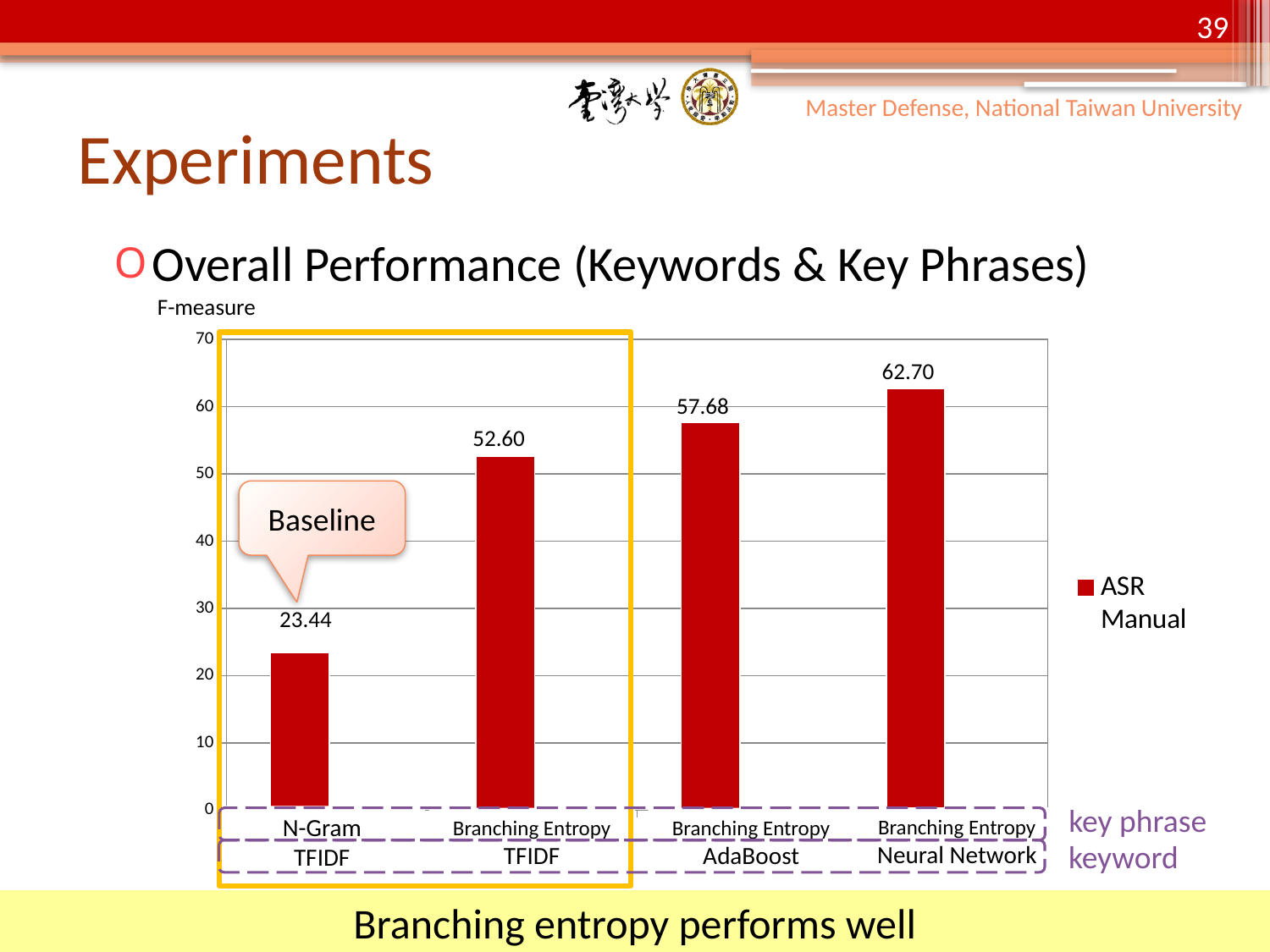
Which bar is labelled as the Baseline in the chart? N-Gram with TFIDF Which configuration has the lowest F-measure? N-Gram with TFIDF Do the F-measure values rise or fall from left to right across the bars? rise What is the F-measure for Branching Entropy with TFIDF? 52.60 What is the F-measure for N-Gram with TFIDF? 23.44 What type of chart is shown on the slide? bar chart Which has a higher F-measure: Branching Entropy with AdaBoost or Branching Entropy with TFIDF? Branching Entropy with AdaBoost How many bars are plotted in the chart? 4 Which configuration has the highest F-measure? Branching Entropy with Neural Network What is the F-measure for Branching Entropy with AdaBoost? 57.68 What is the F-measure for Branching Entropy with Neural Network? 62.70 What is the difference in F-measure between Branching Entropy with Neural Network and N-Gram with TFIDF? 39.26